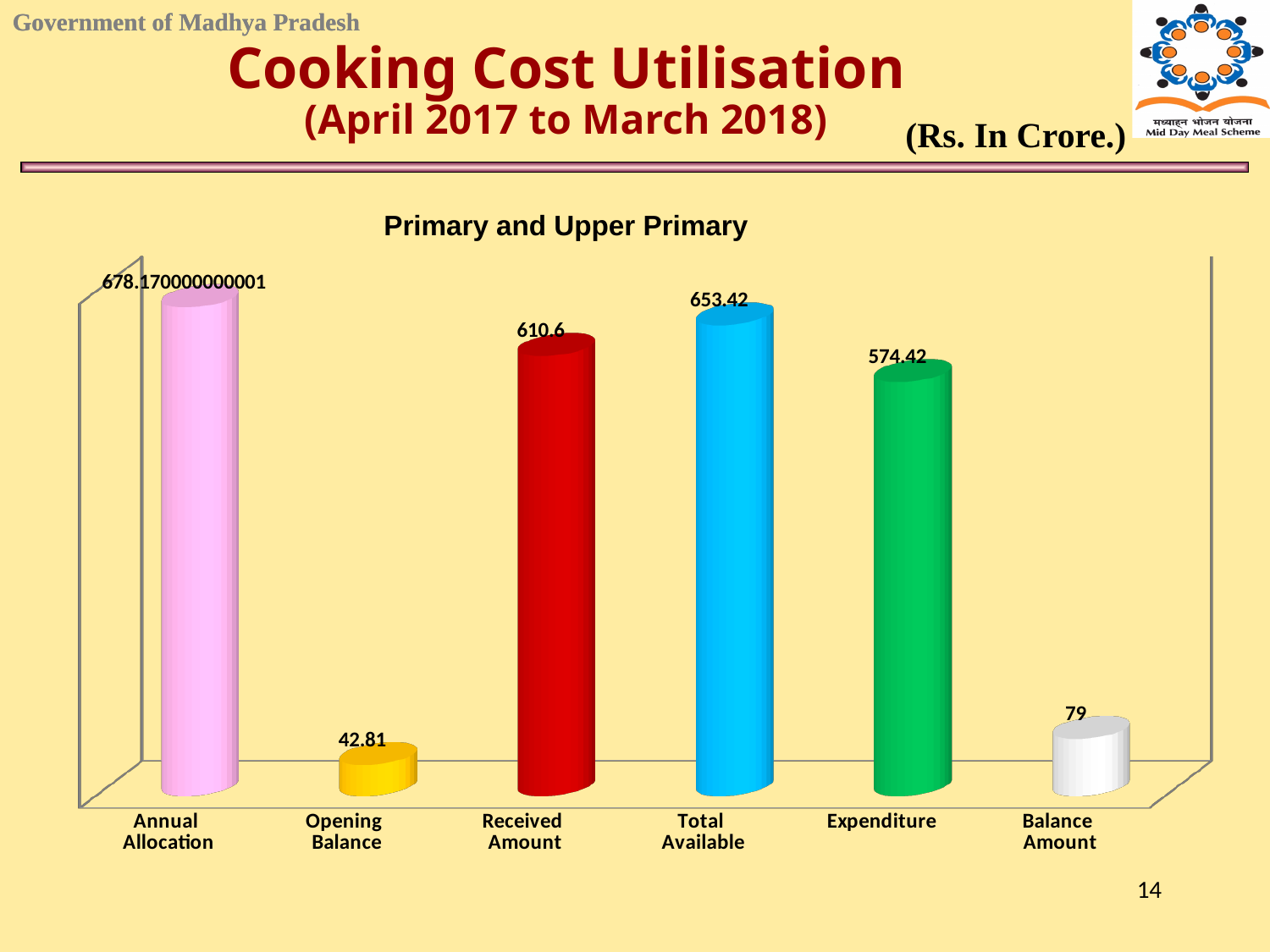
What is the value for Received Amount? 610.6 What is the difference between Total Available and Expenditure? 79 Which category has the highest value? Annual Allocation What type of chart is shown on the slide? Bar chart What is the value for Opening Balance? 42.81 What is the value for Balance Amount? 79 What is the value for Total Available? 653.42 Which category has the lowest value? Opening Balance What is the value for Expenditure? 574.42 What is the value for Annual Allocation? 678.170000000001 How many categories are shown in the chart? 6 Which is larger, Received Amount or Expenditure? Received Amount